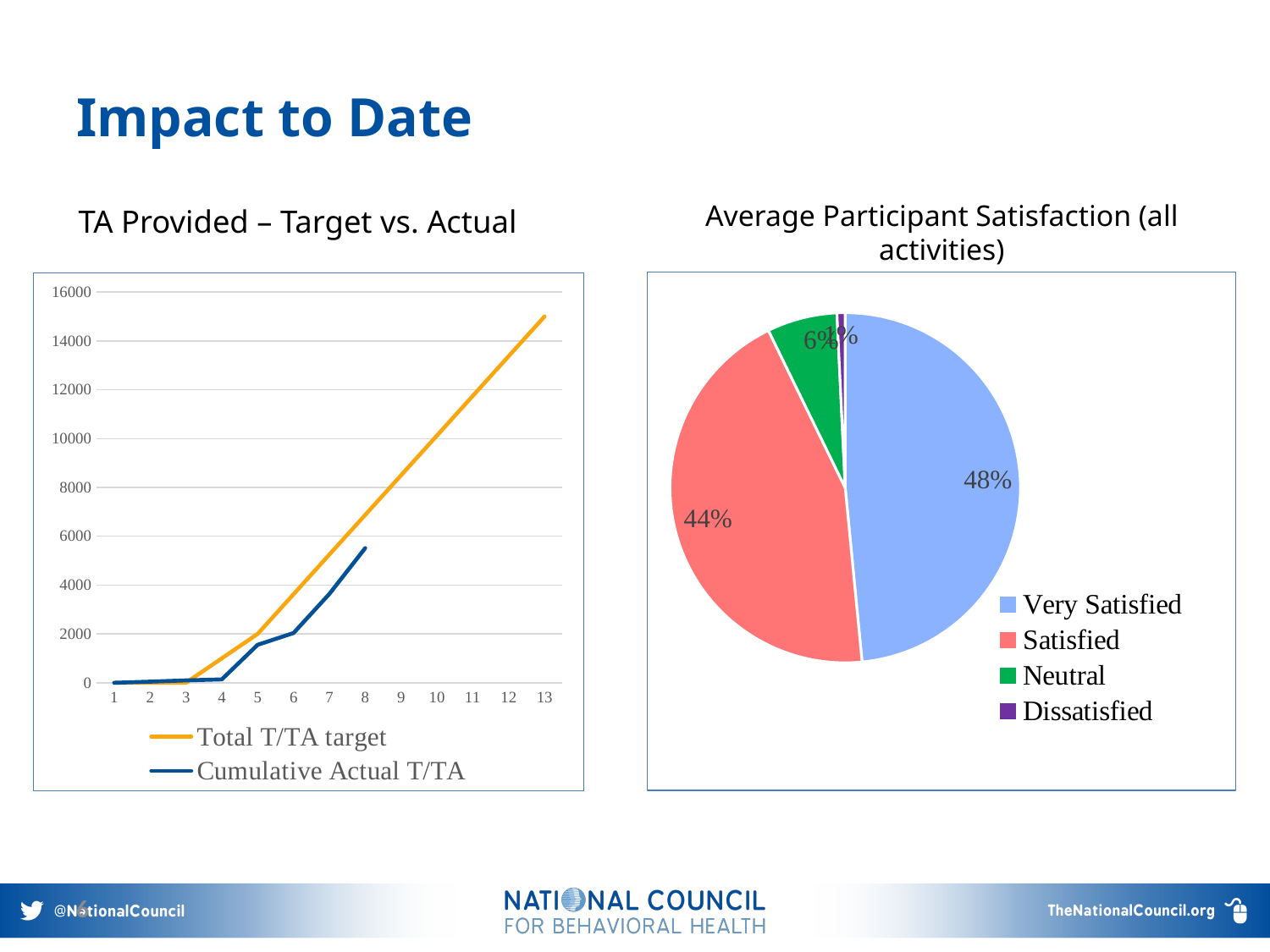
In the 'Average Participant Satisfaction (all activities)' pie chart, what share is Very Satisfied? 48% In the 'TA Provided – Target vs. Actual' chart, how many series does the legend list? 2 In the 'TA Provided – Target vs. Actual' chart, what kind of chart is it? Line chart In the 'TA Provided – Target vs. Actual' chart, which series is higher at point 8, Total T/TA target or Cumulative Actual T/TA? Total T/TA target In the 'Average Participant Satisfaction (all activities)' pie chart, how many categories does the legend list? 4 In the 'TA Provided – Target vs. Actual' chart, is the Total T/TA target value at point 13 greater or less than 14000? greater In the 'TA Provided – Target vs. Actual' chart, is the Cumulative Actual T/TA value at point 5 greater or less than 2000? less In the 'Average Participant Satisfaction (all activities)' pie chart, what is the difference between the Very Satisfied and Satisfied shares? 4% In the 'TA Provided – Target vs. Actual' chart, is the Cumulative Actual T/TA value at point 8 greater or less than 4000? greater In the 'TA Provided – Target vs. Actual' chart, how many points are on the x axis? 13 In the 'Average Participant Satisfaction (all activities)' pie chart, which category has the smallest slice? Dissatisfied In the 'TA Provided – Target vs. Actual' chart, does the Total T/TA target line rise or fall along the x axis? Rise